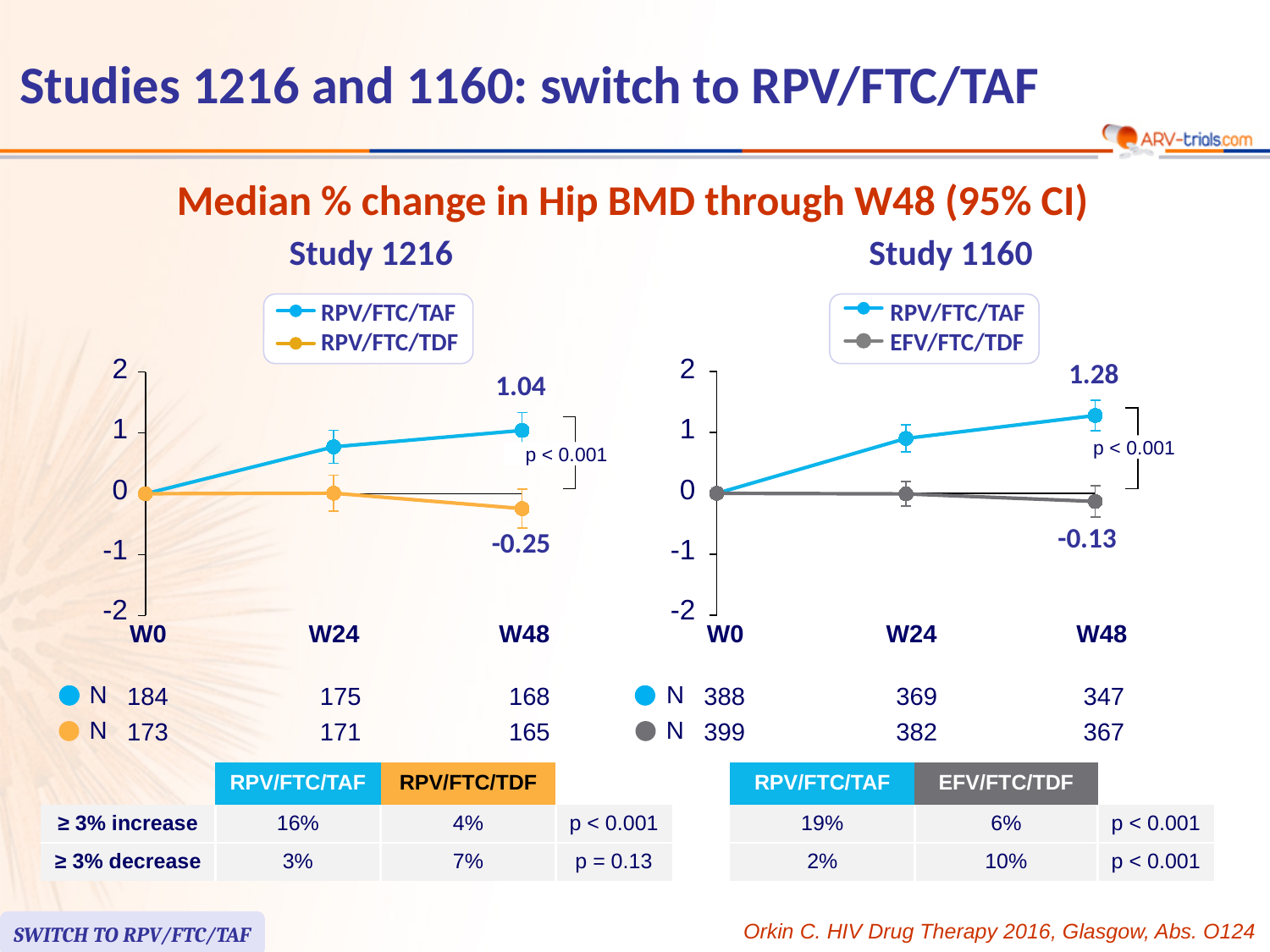
In the Study 1160 chart, what is the difference between the W48 values for RPV/FTC/TAF and EFV/FTC/TDF? 1.41 What type of chart is used for Study 1216? Line chart In the Study 1160 chart, what is the median % change in hip BMD at W48 for RPV/FTC/TAF? 1.28 In the Study 1160 chart, what is the median % change in hip BMD at W48 for EFV/FTC/TDF? -0.13 In the Study 1216 chart, what is the median % change in hip BMD at W48 for RPV/FTC/TDF? -0.25 In the Study 1216 chart, is the W24 value for RPV/FTC/TAF greater or less than 0? greater In the Study 1216 chart, what is the median % change in hip BMD at W48 for RPV/FTC/TAF? 1.04 In the Study 1216 chart, what is the difference between the W48 values for RPV/FTC/TAF and RPV/FTC/TDF? 1.29 How many time points are plotted on the x axis of the Study 1216 chart? 3 How many series does the legend of the Study 1160 chart list? 2 In the Study 1160 chart, is the W24 value for RPV/FTC/TAF greater or less than 0? greater In the Study 1160 chart, which series has the higher value at W48, RPV/FTC/TAF or EFV/FTC/TDF? RPV/FTC/TAF